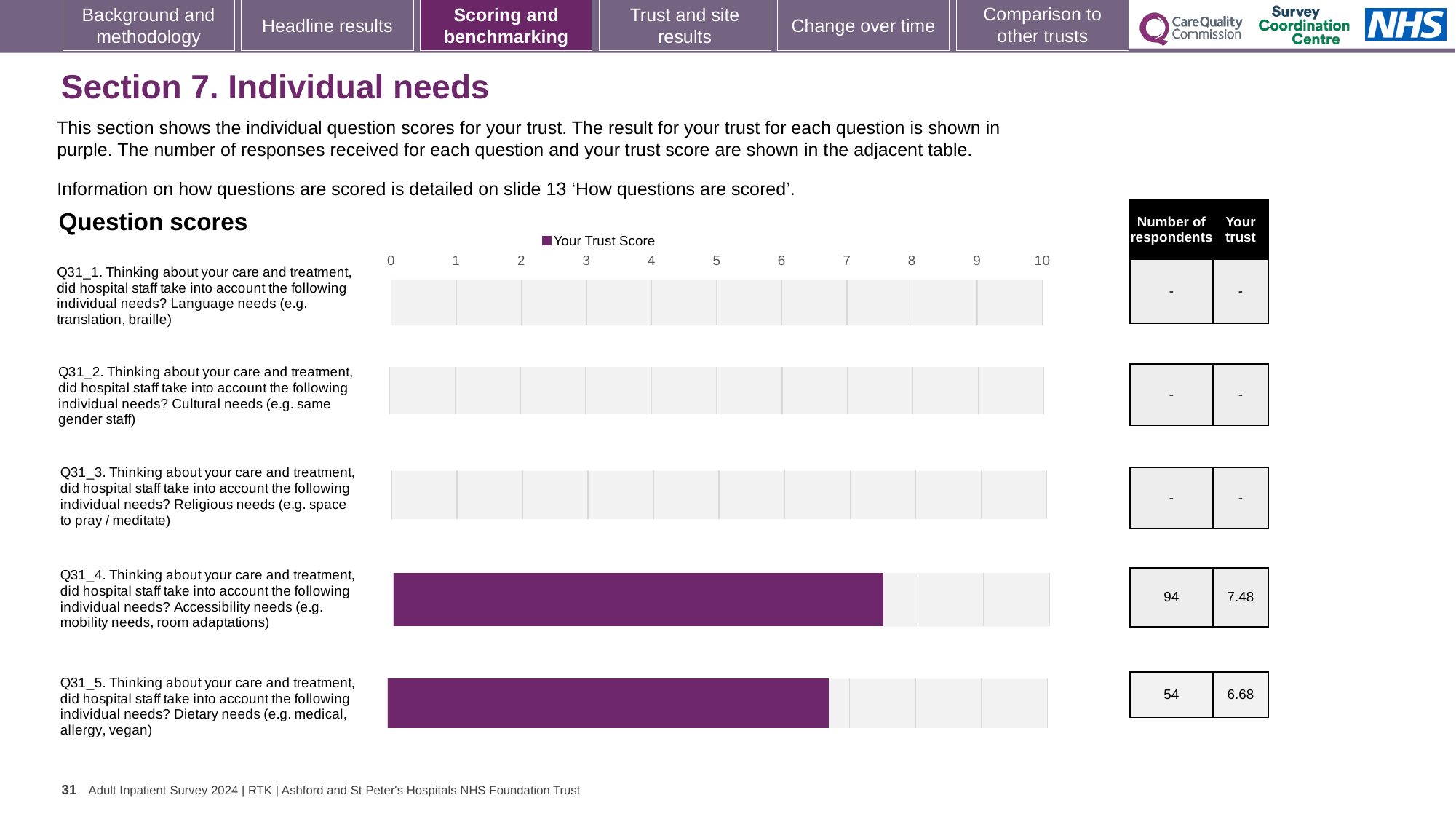
Which question has the higher trust score, Q31_4 (accessibility needs) or Q31_5 (dietary needs)? Q31_4 What type of chart is used to show the question scores on this slide? Bar chart On the Q31_5 chart (dietary needs), what is the trust score shown in the adjacent table? 6.68 What is the difference between the trust scores for Q31_4 (accessibility needs) and Q31_5 (dietary needs)? 0.80 What is the maximum value shown on the horizontal axis of the question score charts? 10 How many respondents are listed for Q31_5 (dietary needs)? 54 On the Q31_4 chart (accessibility needs), what is the trust score shown in the adjacent table? 7.48 How many series does the chart legend list? 1 How many question charts on this slide have no bar plotted (score shown as '-')? 3 Is the trust score bar for Q31_4 (accessibility needs) greater or less than 7? greater Is the trust score bar for Q31_5 (dietary needs) greater or less than 7? less How many respondents are listed for Q31_4 (accessibility needs)? 94